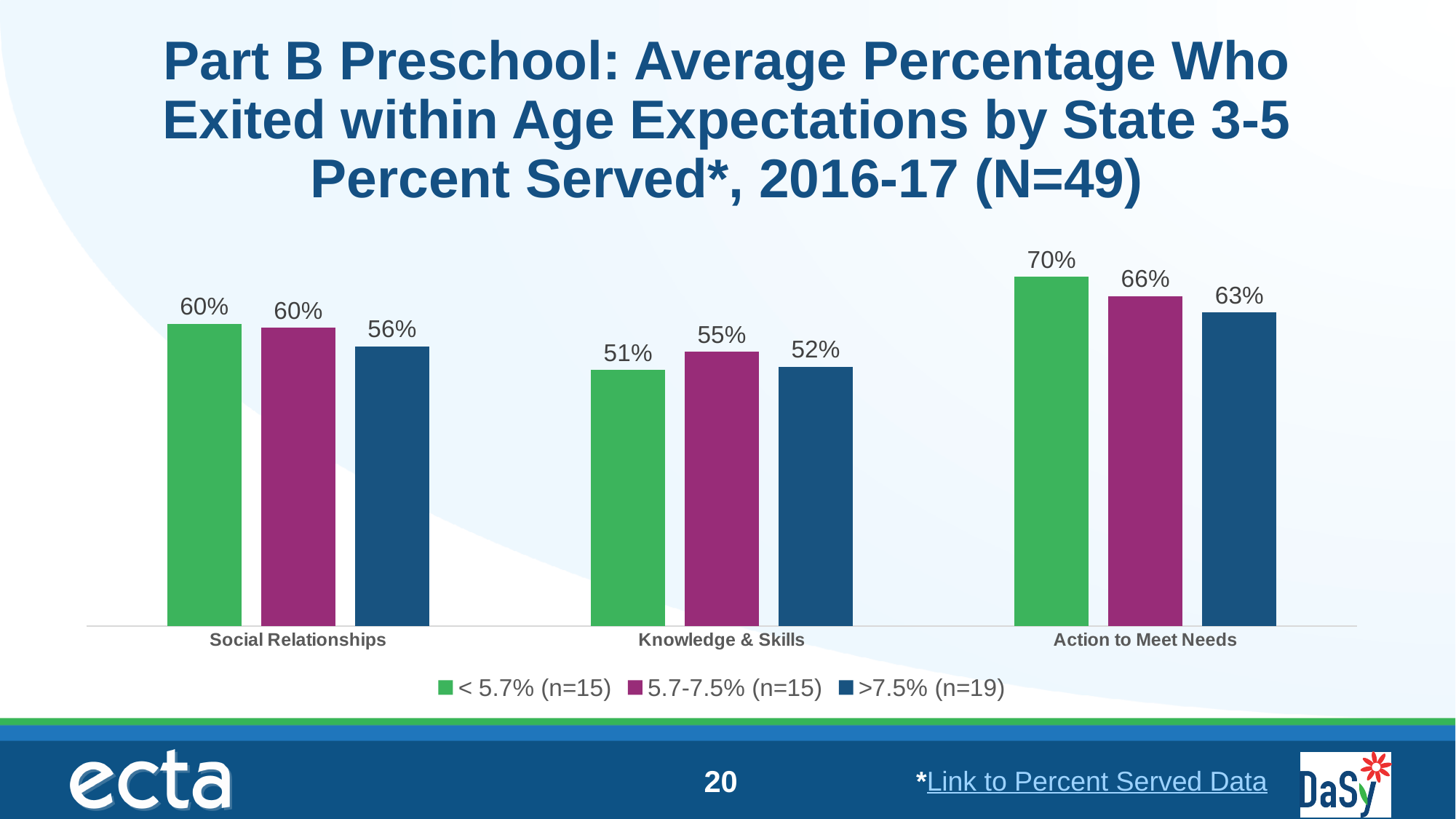
What is the value for Knowledge & Skills in the 5.7-7.5% (n=15) series? 55% What is the difference between the Social Relationships and Knowledge & Skills values in the < 5.7% (n=15) series? 9% Which category has the lowest value in the >7.5% (n=19) series? Knowledge & Skills What is the difference between the < 5.7% (n=15) and >7.5% (n=19) values for Action to Meet Needs? 7% Which colour represents the >7.5% (n=19) series? Dark blue How many categories are shown on the x axis? 3 Which category has the highest value in the < 5.7% (n=15) series? Action to Meet Needs Which is larger for Knowledge & Skills: the < 5.7% (n=15) value or the 5.7-7.5% (n=15) value? 5.7-7.5% (n=15) What is the value for Social Relationships in the < 5.7% (n=15) series? 60% What is the value for Action to Meet Needs in the >7.5% (n=19) series? 63% How many series does the legend list? 3 What kind of chart is shown on the slide? Bar chart